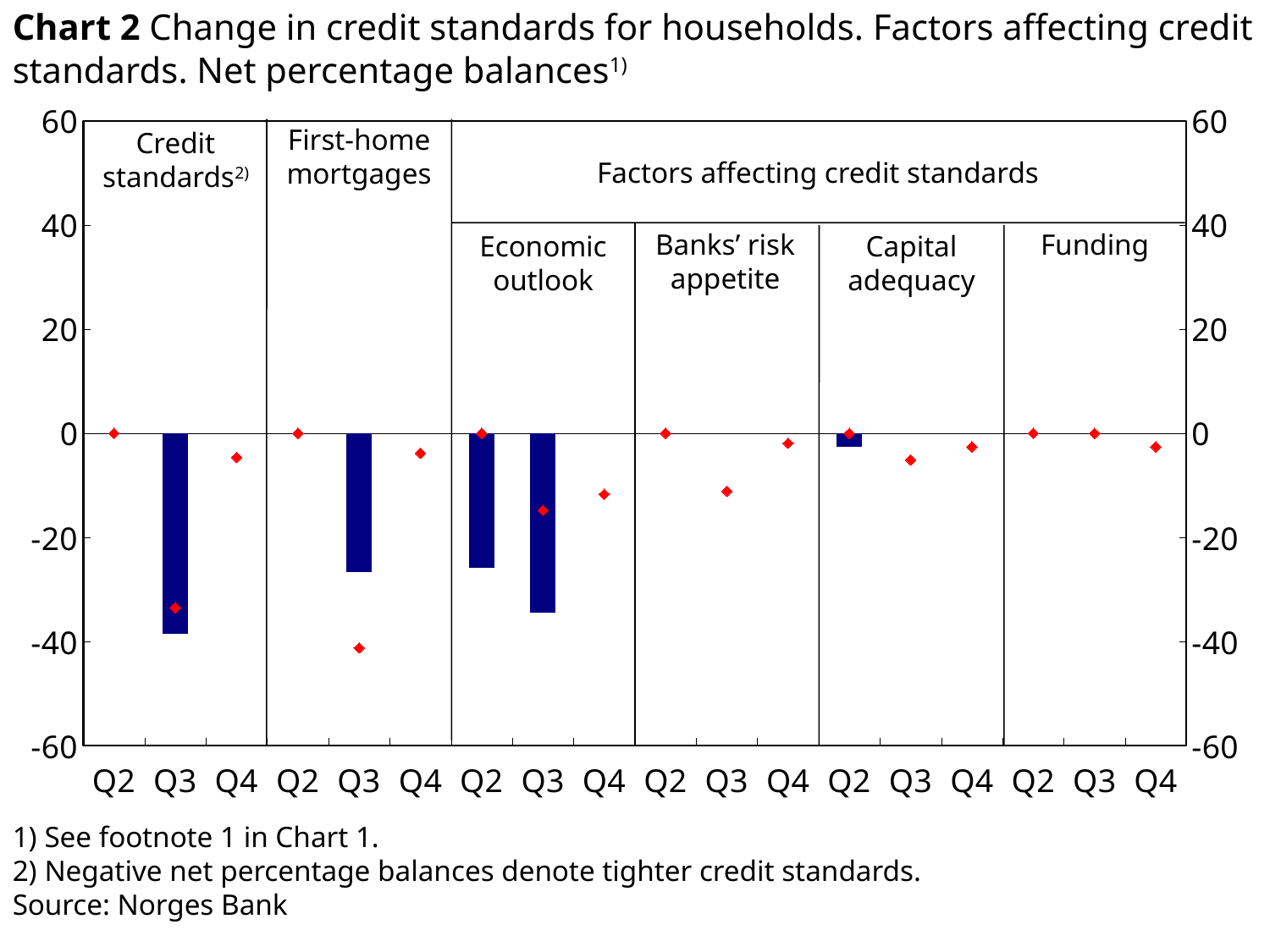
In the First-home mortgages panel, is the bar for Q3 greater or less than -20? less What is the highest value shown on the y axis? 60 How many factor panels are shown under 'Factors affecting credit standards'? 4 How many quarters are shown on the x axis within each panel? 3 In the Capital adequacy panel, is the bar for Q2 greater or less than -20? greater In the Credit standards panel, is the bar for Q3 greater or less than -20? less What kind of chart is Chart 2? bar chart Which Q3 bar is lower: Credit standards or First-home mortgages? Credit standards What is the source given for Chart 2? Norges Bank In the Credit standards panel, which quarter has the lowest bar? Q3 In the Economic outlook panel, which bar is lower: Q2 or Q3? Q3